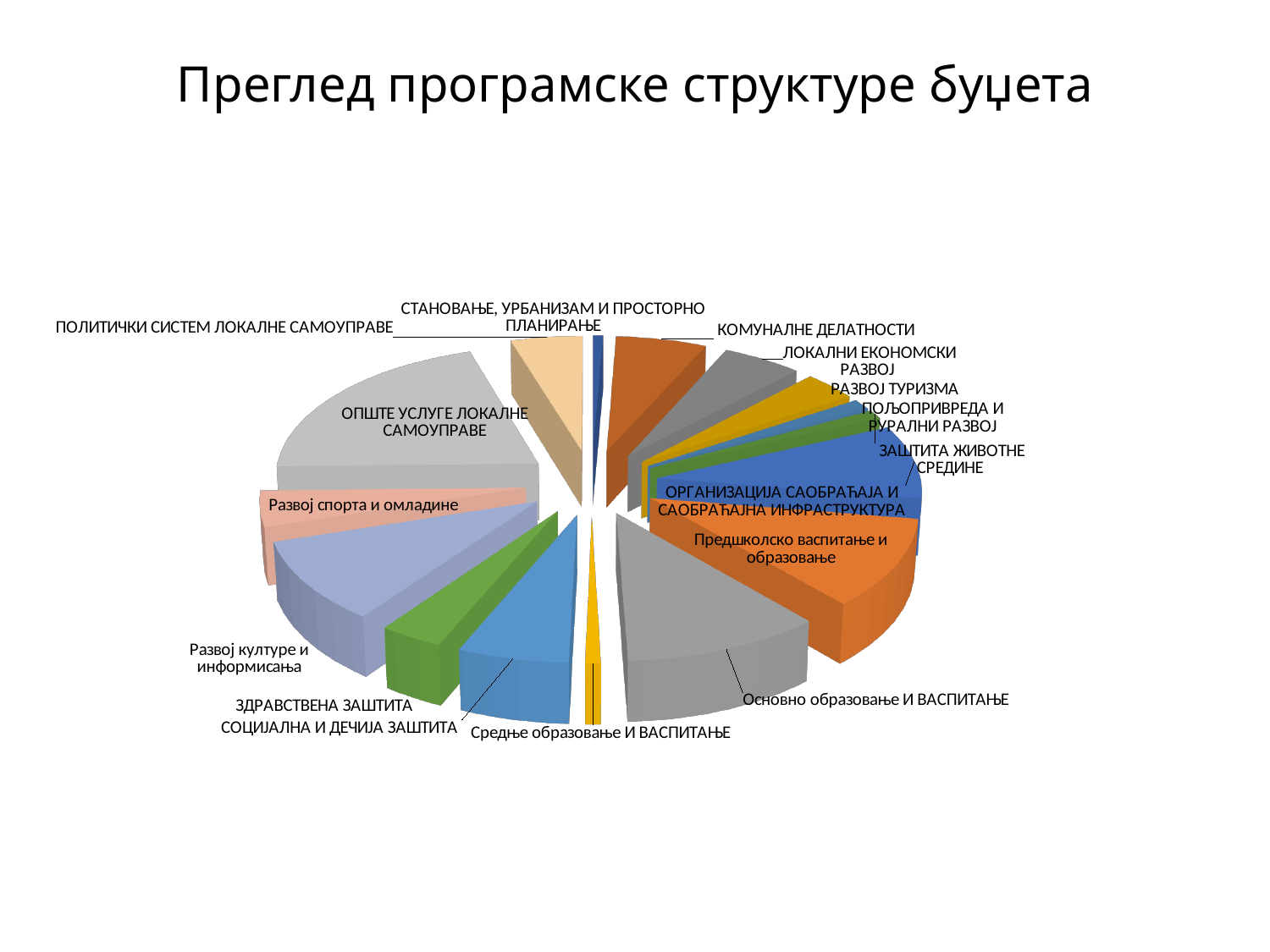
What is the title of the slide? Преглед програмске структуре буџета Which slice is larger: ОПШТЕ УСЛУГЕ ЛОКАЛНЕ САМОУПРАВЕ or РАЗВОЈ ТУРИЗМА? ОПШТЕ УСЛУГЕ ЛОКАЛНЕ САМОУПРАВЕ What colour is the slice for Предшколско васпитање и образовање? orange How many slices (categories) does the pie chart have? 16 What kind of chart is shown on the slide? pie chart Which slice is larger: Развој спорта и омладине or Средње образовање И ВАСПИТАЊЕ? Развој спорта и омладине Which slice is larger: Основно образовање И ВАСПИТАЊЕ or ЛОКАЛНИ ЕКОНОМСКИ РАЗВОЈ? Основно образовање И ВАСПИТАЊЕ